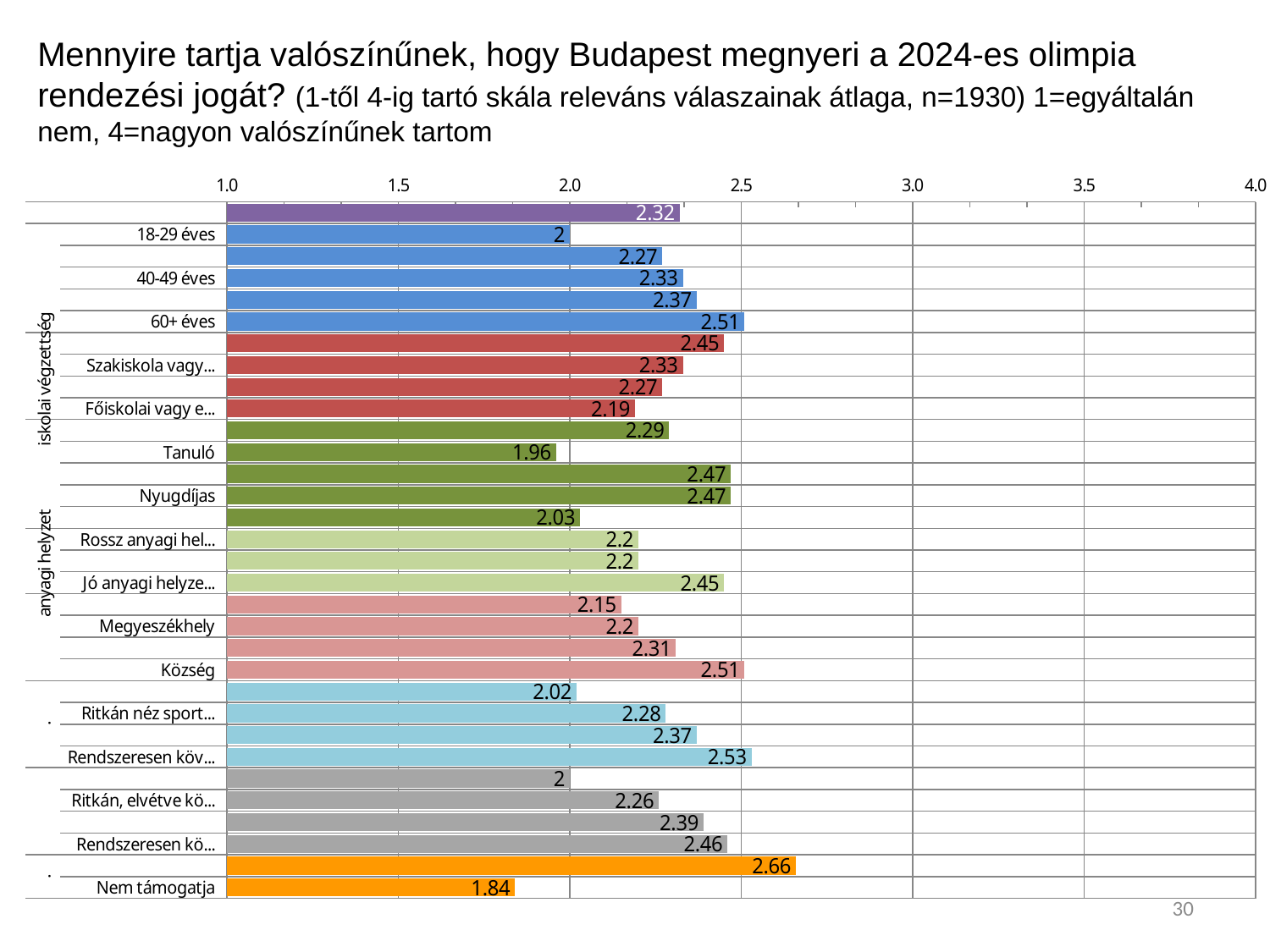
What is the highest value shown in the chart? 2.66 What is the value for Tanuló? 1.96 What is the value for 18-29 éves? 2 What kind of chart is shown on the slide? bar chart What is the value for 60+ éves? 2.51 Is the value for Megyeszékhely greater or less than 2.5? less What is the difference between the values for 60+ éves and 18-29 éves? 0.51 What is the value for Község? 2.51 Which category has the lowest value in the chart? Nem támogatja What is the value for Nem támogatja? 1.84 Which is larger, the value for Nyugdíjas or the value for Tanuló? Nyugdíjas What is the value for Nyugdíjas? 2.47